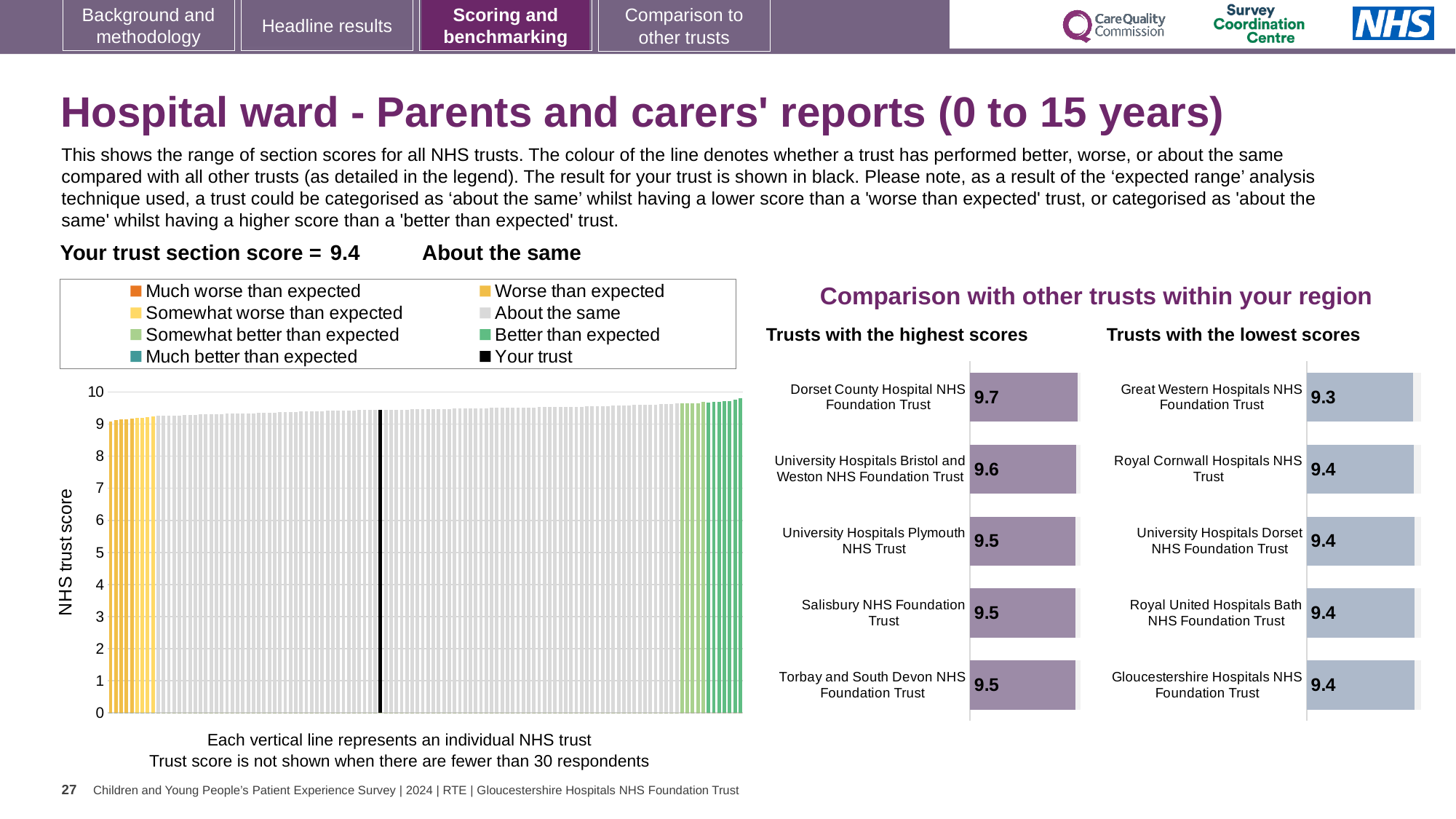
In the 'Trusts with the highest scores' chart, what is the score for Dorset County Hospital NHS Foundation Trust? 9.7 In the 'Trusts with the lowest scores' chart, what is the score for Great Western Hospitals NHS Foundation Trust? 9.3 In the main chart on the left, is the value for the black 'Your trust' line greater or less than 9? greater In the 'Trusts with the lowest scores' chart, which trust has the lowest score? Great Western Hospitals NHS Foundation Trust What type of chart is the 'Trusts with the lowest scores' chart? Bar chart In the 'Trusts with the highest scores' chart, what is the difference between the scores of Dorset County Hospital NHS Foundation Trust and Salisbury NHS Foundation Trust? 0.2 In the 'Trusts with the lowest scores' chart, what is the score for Gloucestershire Hospitals NHS Foundation Trust? 9.4 How many trusts are shown in the 'Trusts with the highest scores' chart? 5 In the 'Trusts with the highest scores' chart, what is the score for University Hospitals Bristol and Weston NHS Foundation Trust? 9.6 What is the y-axis label of the main chart on the left? NHS trust score Which has the higher score: Dorset County Hospital NHS Foundation Trust in the highest scores chart or Great Western Hospitals NHS Foundation Trust in the lowest scores chart? Dorset County Hospital NHS Foundation Trust In the 'Trusts with the highest scores' chart, which trust has the highest score? Dorset County Hospital NHS Foundation Trust